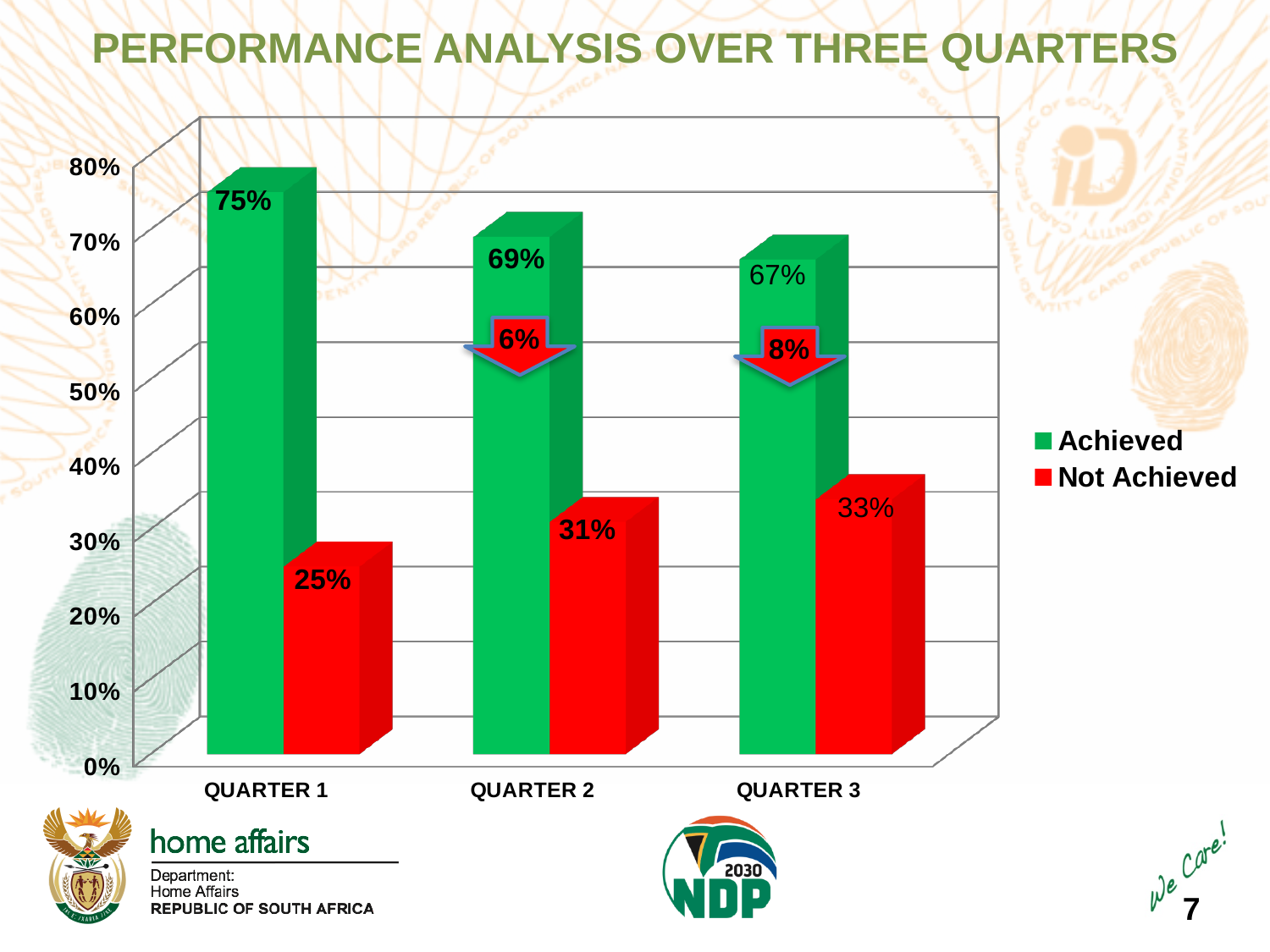
What is the Achieved value for Quarter 2? 69% What is the Achieved value for Quarter 1? 75% What is the difference between the Achieved values for Quarter 1 and Quarter 3? 8% What colour represents the Not Achieved series? Red Which quarter has the highest Achieved value? Quarter 1 Which quarter has the lowest Not Achieved value? Quarter 1 Which is larger: the Not Achieved value for Quarter 2 or the Not Achieved value for Quarter 3? Quarter 3 What kind of chart is shown on the slide? Bar chart Do the Achieved values rise or fall from Quarter 1 to Quarter 3? Fall How many series does the legend list? 2 What is the Not Achieved value for Quarter 3? 33% How many quarters are shown on the x axis? 3